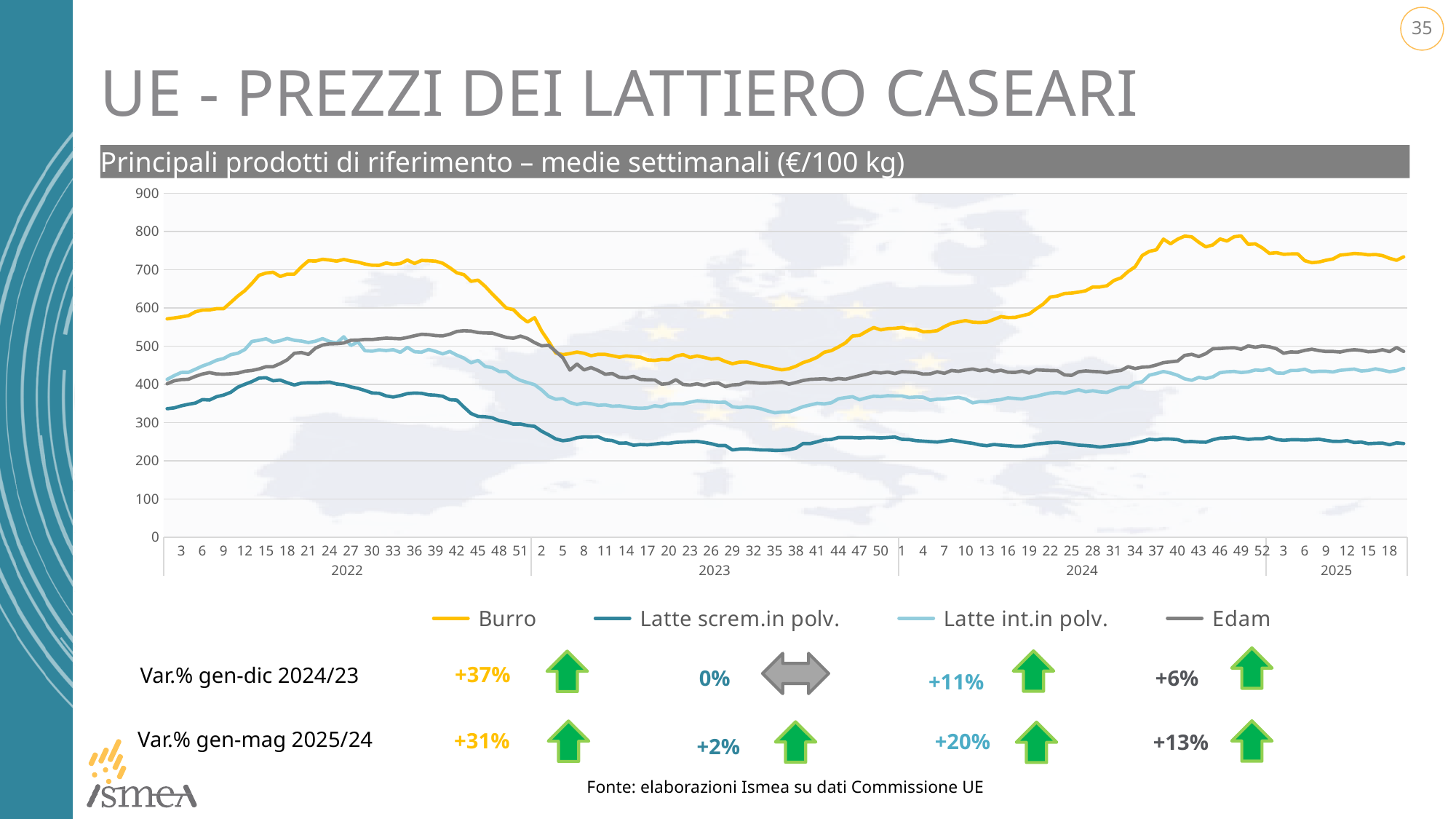
Does the Burro line rise or fall between week 39 of 2022 and week 5 of 2023? fall Which series has the highest values in 2025? Burro What is the Var.% gen-dic 2024/23 shown for Burro? +37% What is the Var.% gen-mag 2025/24 shown for Latte int.in polv.? +20% Is the value for Burro at week 40 of 2024 greater or less than 700? greater Which is larger at week 18 of 2025, Edam or Latte int.in polv.? Edam How many series does the chart legend list? 4 What is the Var.% gen-dic 2024/23 shown for Latte screm.in polv.? 0% What is the subtitle printed above the chart? Principali prodotti di riferimento – medie settimanali (€/100 kg) What kind of chart is shown on the slide? line chart Is the value for Latte screm.in polv. at week 18 of 2025 greater or less than 300? less Which series has the lowest values in 2025? Latte screm.in polv.